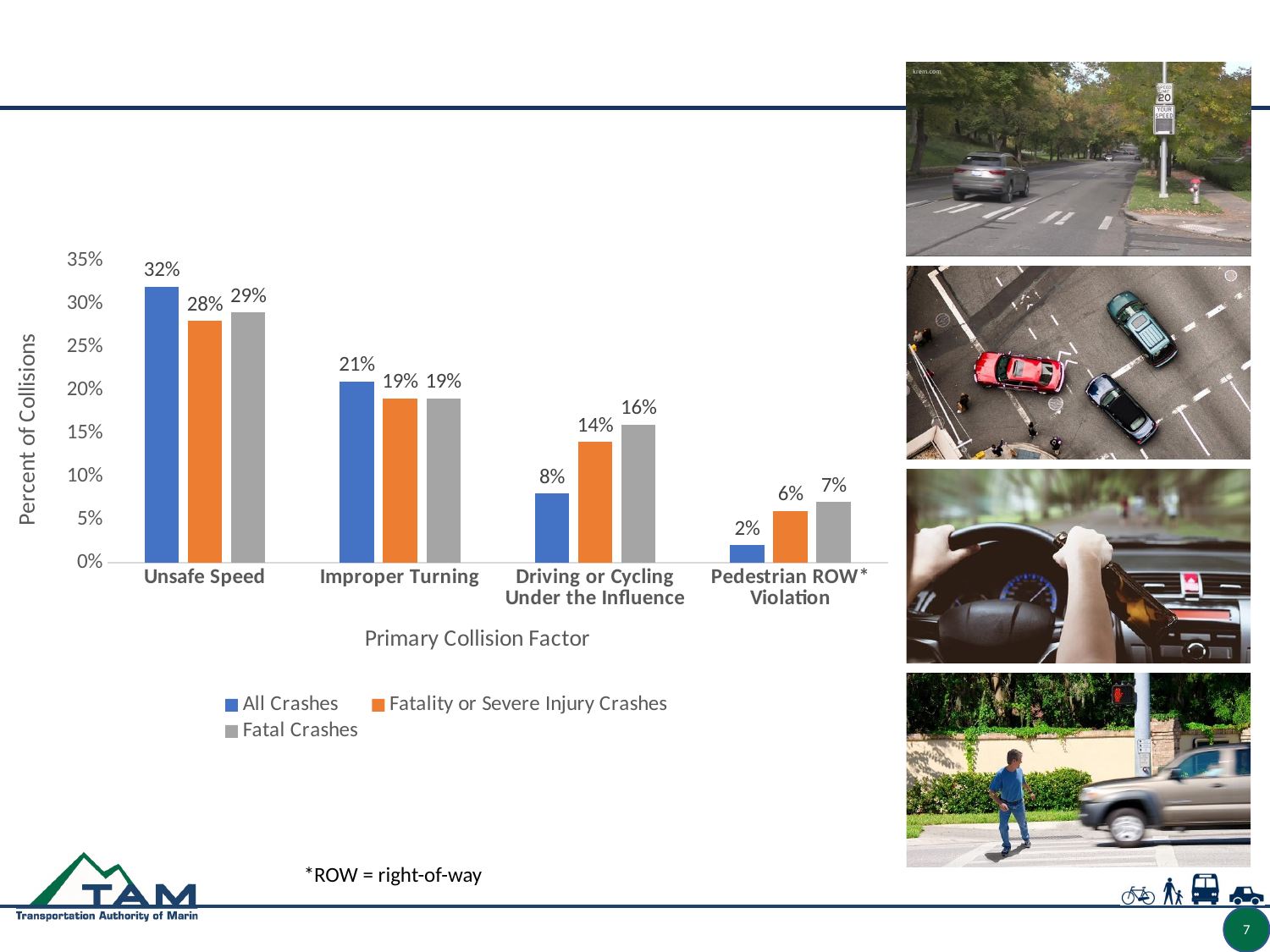
How many series does the legend list? 3 What is the value for Fatality or Severe Injury Crashes in the Pedestrian ROW Violation category? 6% Which primary collision factor has the lowest value for Fatal Crashes? Pedestrian ROW* Violation What percent of All Crashes have Unsafe Speed as the primary collision factor? 32% What is the difference between the All Crashes value and the Fatal Crashes value for Driving or Cycling Under the Influence? 8% What kind of chart is shown on the slide? Bar chart What is the value for Fatal Crashes in the Driving or Cycling Under the Influence category? 16% Which primary collision factor has the highest value for All Crashes? Unsafe Speed Do the All Crashes values rise or fall moving from Unsafe Speed to Pedestrian ROW Violation along the x axis? Fall For Unsafe Speed, which series has the larger value: All Crashes or Fatality or Severe Injury Crashes? All Crashes How many primary collision factor categories are shown on the x axis? 4 What is the label of the y axis? Percent of Collisions